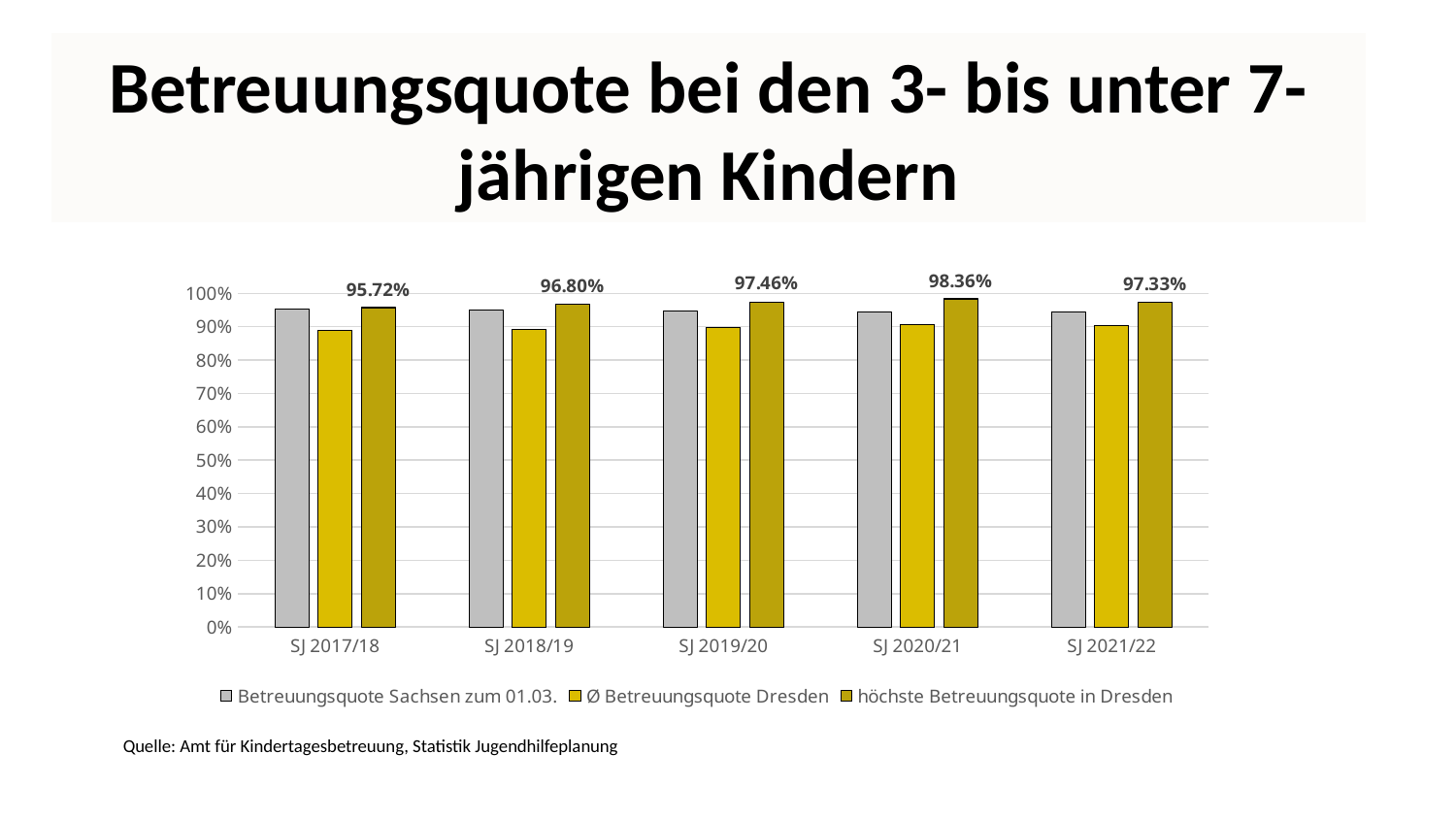
In which school year is the 'höchste Betreuungsquote in Dresden' the highest? SJ 2020/21 What is the value of 'höchste Betreuungsquote in Dresden' for SJ 2017/18? 95.72% How many series does the legend list? 3 Is the value for 'Betreuungsquote Sachsen zum 01.03.' in SJ 2017/18 greater or less than 90%? greater What is the difference in 'höchste Betreuungsquote in Dresden' between SJ 2020/21 and SJ 2017/18? 2.64 percentage points What kind of chart is shown on the slide? Bar chart Is the value for 'Ø Betreuungsquote Dresden' in SJ 2020/21 greater or less than 80%? greater What is the value of 'höchste Betreuungsquote in Dresden' for SJ 2019/20? 97.46% In which school year is the 'höchste Betreuungsquote in Dresden' the lowest? SJ 2017/18 What is the value of 'höchste Betreuungsquote in Dresden' for SJ 2020/21? 98.36% How many school years are shown on the x axis? 5 Which school year has the larger 'höchste Betreuungsquote in Dresden', SJ 2018/19 or SJ 2021/22? SJ 2021/22